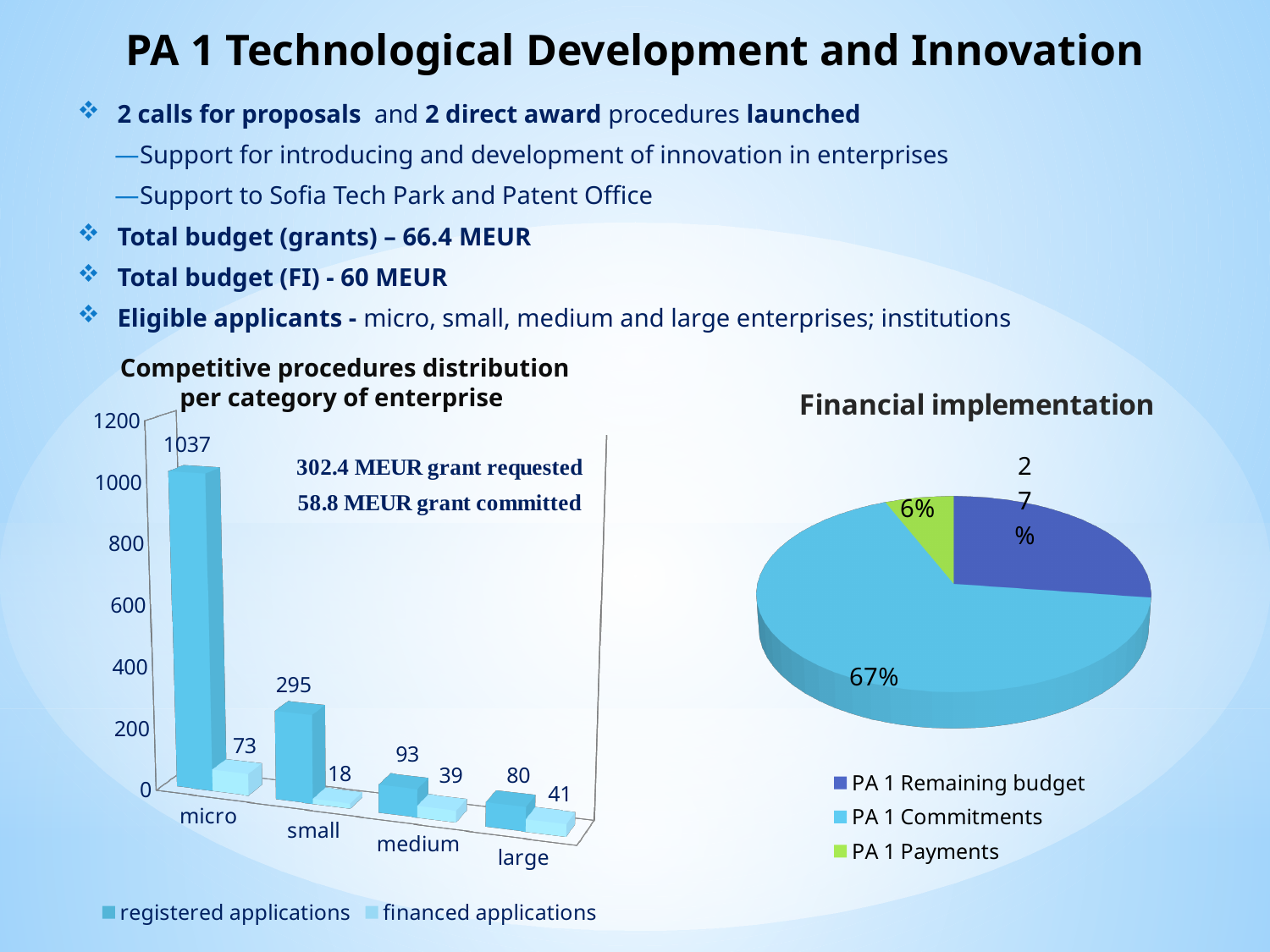
What kind of chart is 'Competitive procedures distribution per category of enterprise'? bar chart What kind of chart is 'Financial implementation'? pie chart In the 'Financial implementation' chart, what share is PA 1 Commitments? 67% In the 'Competitive procedures distribution per category of enterprise' chart, how many series does the legend list? 2 In the 'Competitive procedures distribution per category of enterprise' chart, which category has the lowest number of financed applications? small In the 'Competitive procedures distribution per category of enterprise' chart, how many enterprise categories are shown on the x axis? 4 In the 'Competitive procedures distribution per category of enterprise' chart, how many financed applications are there for medium enterprises? 39 In the 'Competitive procedures distribution per category of enterprise' chart, what is the difference between registered and financed applications for small enterprises? 277 In the 'Competitive procedures distribution per category of enterprise' chart, which is larger: registered applications for medium enterprises or registered applications for large enterprises? medium In the 'Financial implementation' chart, what share is PA 1 Payments? 6% In the 'Competitive procedures distribution per category of enterprise' chart, how many registered applications are there for micro enterprises? 1037 In the 'Competitive procedures distribution per category of enterprise' chart, which category has the highest number of registered applications? micro